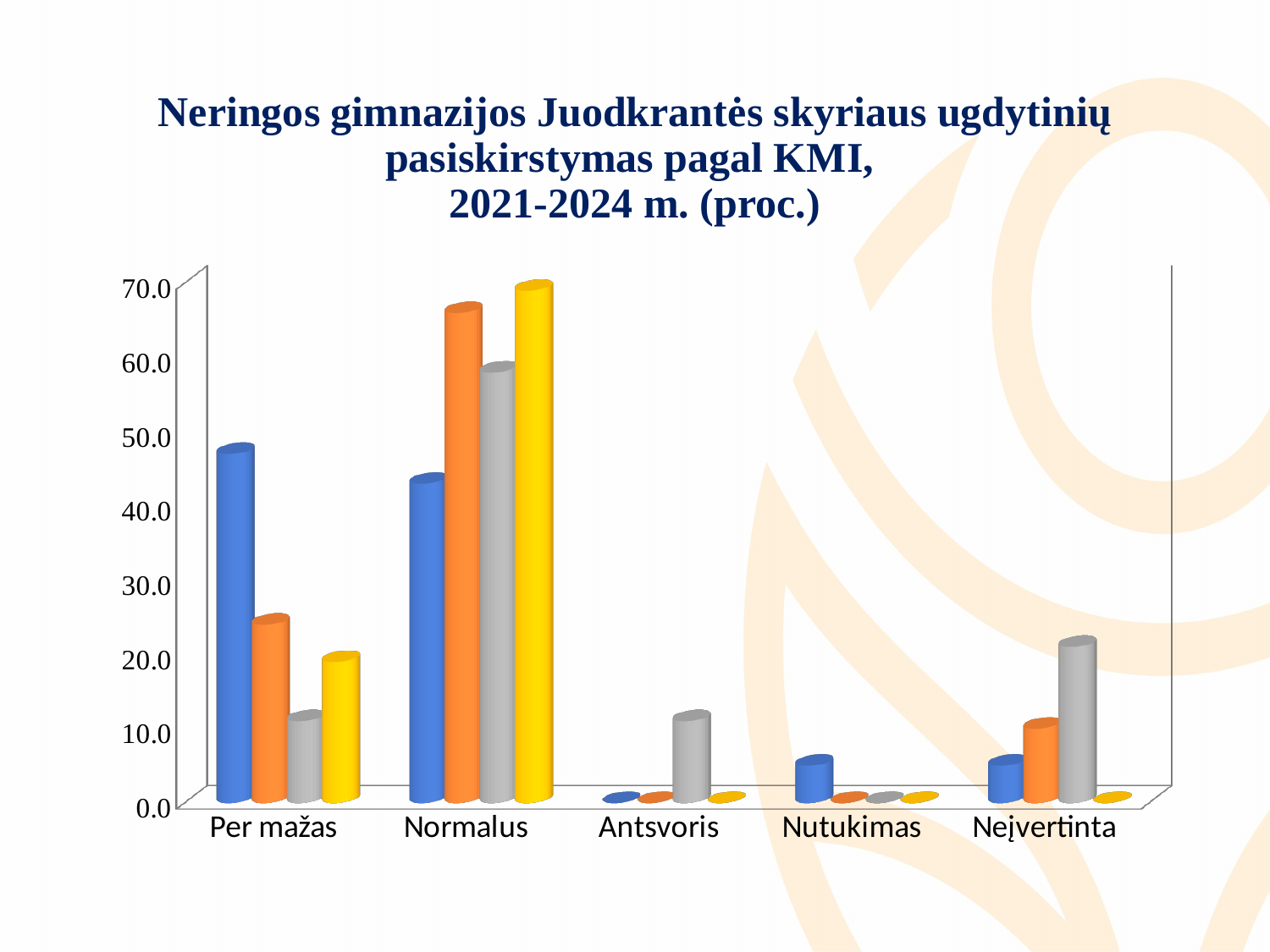
Is the value of the gray bar for Neįvertinta greater or less than 30? less What is the highest value shown on the vertical axis? 70.0 How many bars are plotted for each category? 4 How many categories are shown on the x axis? 5 Is the value of the blue bar for Per mažas greater or less than 40? greater What kind of chart is shown on the slide? bar chart Which category contains the tallest bar in the chart? Normalus Is the value of the gray bar for Normalus greater or less than 50? greater For Normalus, which is taller: the orange bar or the blue bar? orange Which category has the tallest gray bar? Normalus For Per mažas, which is taller: the blue bar or the orange bar? blue